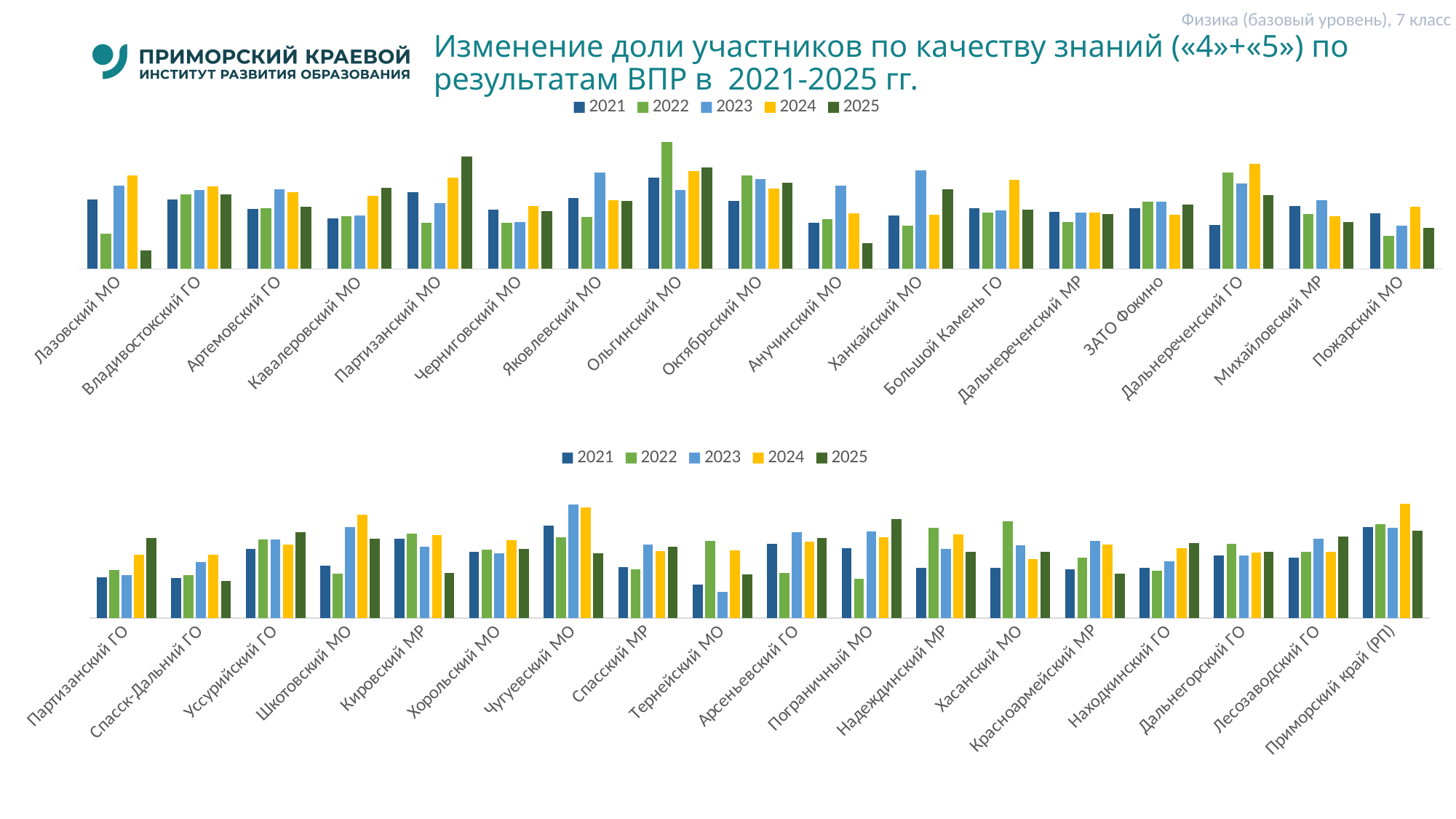
How many series does the legend of the top chart list? 5 How many categories (municipalities) are shown on the x axis of the top chart? 17 In the bottom chart, for Хасанский МО, is the 2022 bar or the 2024 bar taller? 2022 In the top chart, which year has the lowest bar for Лазовский МО? 2025 In the top chart, for Анучинский МО, is the 2023 bar or the 2025 bar taller? 2023 In the bottom chart, which year has the tallest bar for Чугуевский МО? 2023 What kind of chart is the top chart on the slide? bar chart In the bottom chart, which year has the lowest bar for Тернейский МО? 2023 In the top chart, which year has the tallest bar for Ольгинский МО? 2022 In the top chart, which year has the tallest bar for Партизанский МО? 2025 Which years are listed in the legend of the bottom chart? 2021, 2022, 2023, 2024, 2025 How many categories are shown on the x axis of the bottom chart? 18